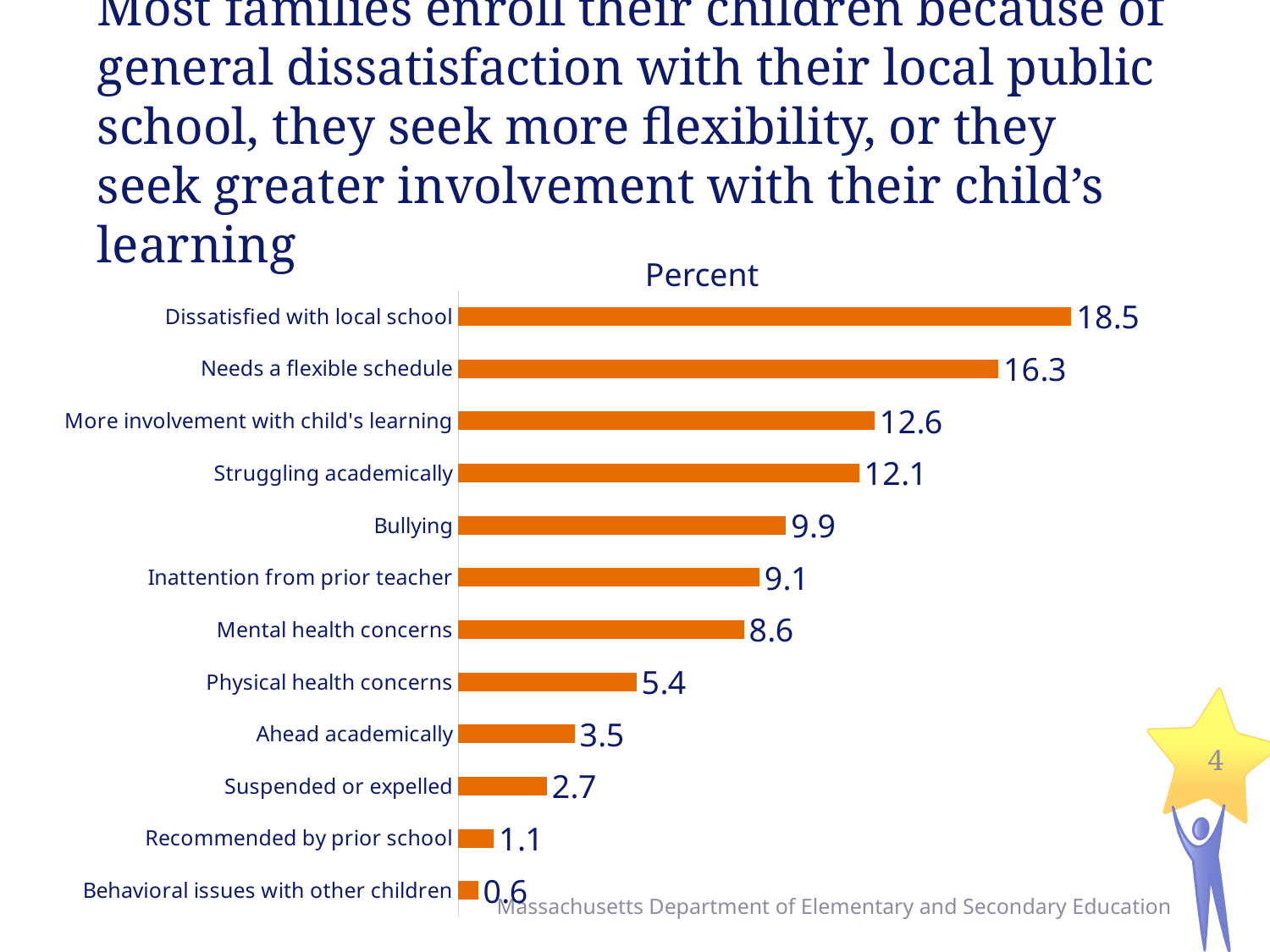
What is the difference between the values for "Ahead academically" and "Recommended by prior school"? 2.4 What is the value for "Dissatisfied with local school"? 18.5 What kind of chart is shown on the slide? Bar chart What is the value for "Physical health concerns"? 5.4 What is the value for "Bullying"? 9.9 What is the value for "Suspended or expelled"? 2.7 What is the title of the chart? Percent Which category has the highest value? Dissatisfied with local school How many categories are shown in the chart? 12 What is the difference between the values for "Needs a flexible schedule" and "More involvement with child's learning"? 3.7 Which is larger, the value for "Mental health concerns" or the value for "Inattention from prior teacher"? Inattention from prior teacher Which category has the lowest value? Behavioral issues with other children